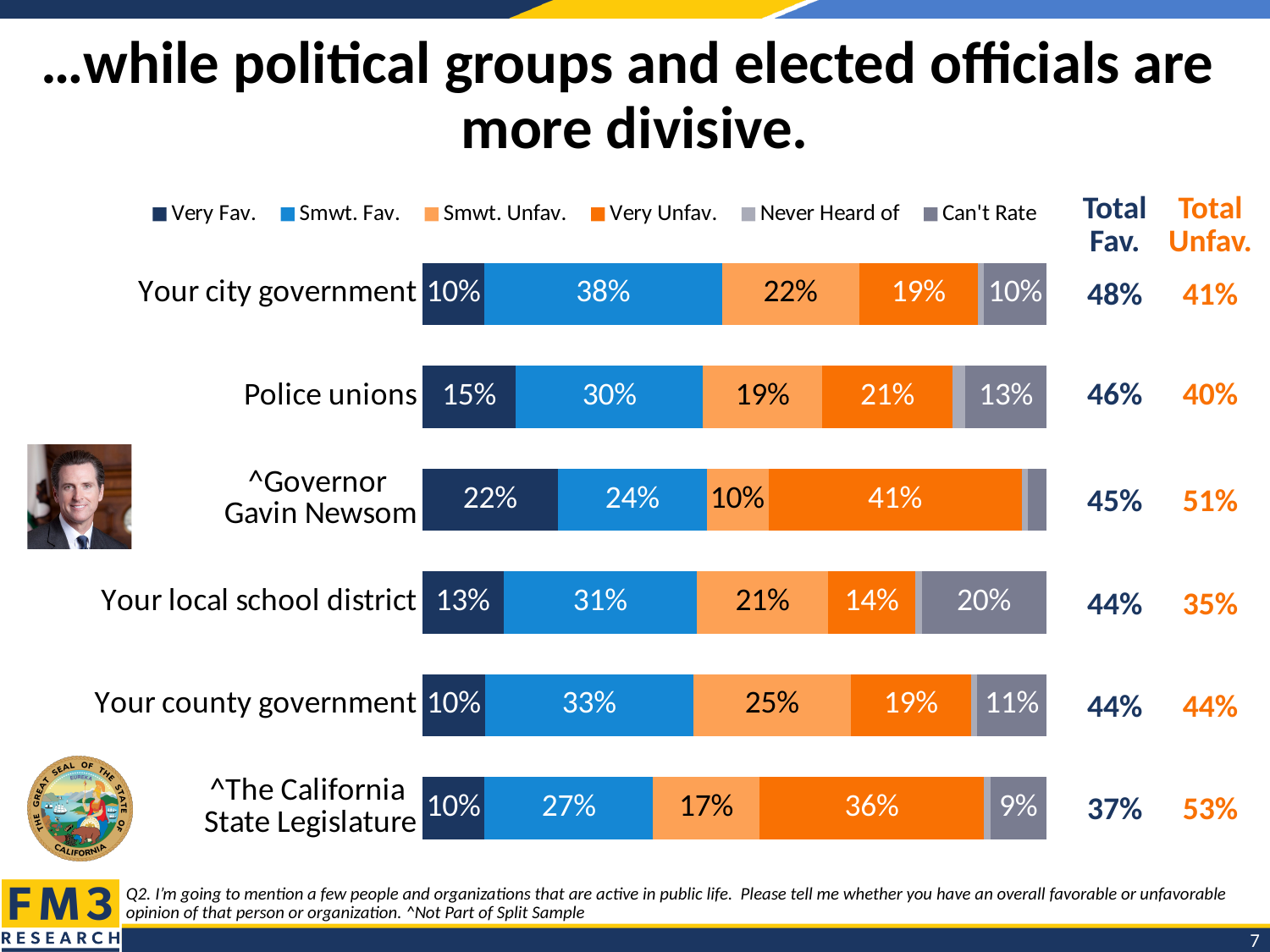
What percentage of respondents have a Very Unfavorable opinion of Governor Gavin Newsom? 41% Which category has the highest Total Favorable value? Your city government How many categories (people or organizations) are shown in the chart? 6 What is the Somewhat Favorable (Smwt. Fav.) value for Your city government? 38% Which category has the highest Very Favorable value? Governor Gavin Newsom What kind of chart is shown on the slide? Stacked bar chart For The California State Legislature, how many percentage points higher is Total Unfavorable than Total Favorable? 16 percentage points What is the Total Unfavorable value for The California State Legislature? 53% How many series does the legend list? 6 Which category has the lowest Total Favorable value? The California State Legislature Which has a larger Very Unfavorable value: Governor Gavin Newsom or The California State Legislature? Governor Gavin Newsom What is the Total Favorable value for Police unions? 46%